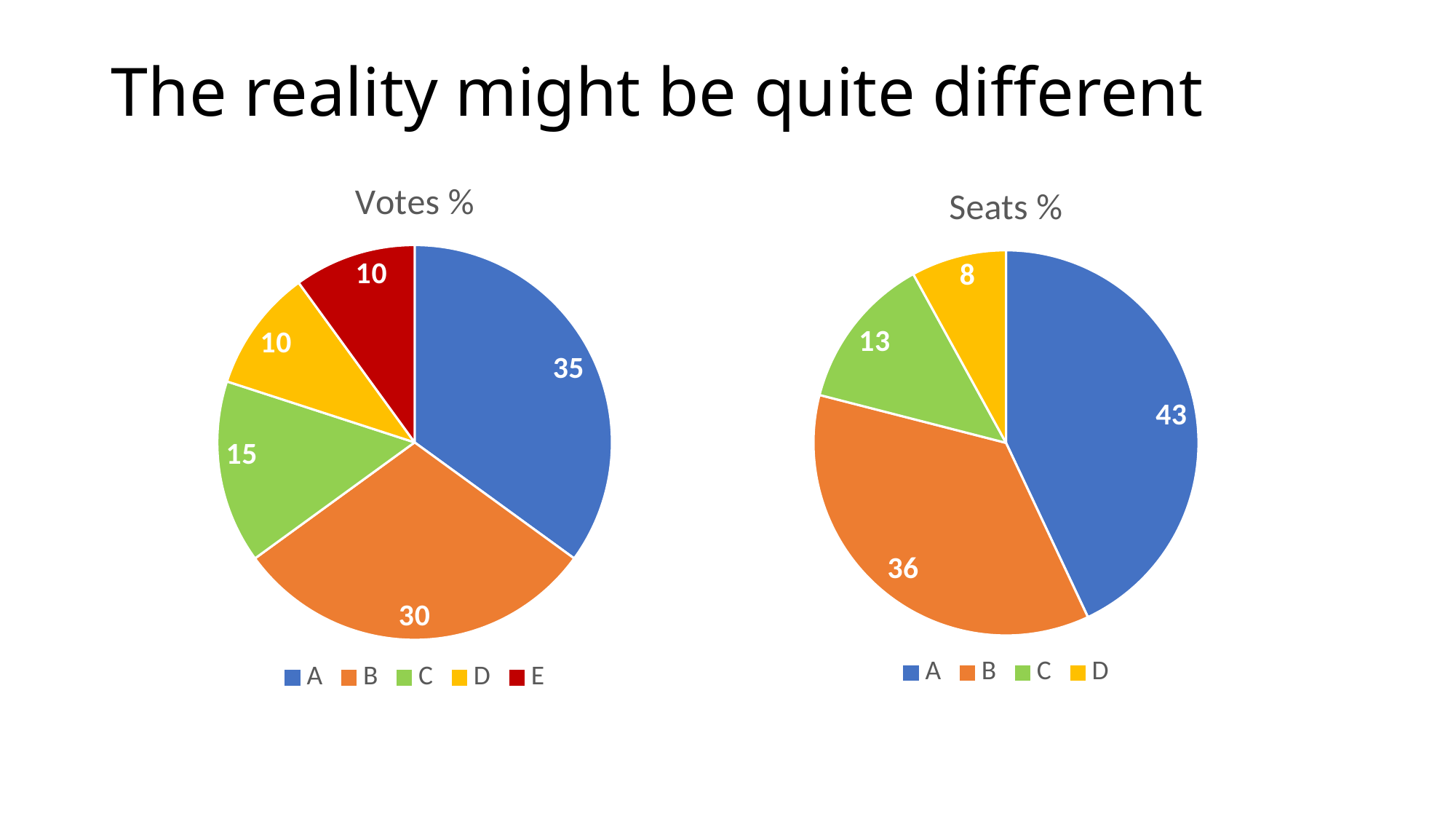
In the Votes % chart, what is the difference between the values for B and C? 15 In the Seats % chart, what is the value for D? 8 What is the difference between the value for A in the Seats % chart and the value for A in the Votes % chart? 8 In the Seats % chart, which is larger, the value for C or the value for D? C In the Seats % chart, which category has the smallest slice? D What kind of chart is the Seats % chart? Pie chart In the Seats % chart, what is the value for B? 36 How many categories does the legend of the Seats % chart list? 4 In the Votes % chart, which category has the largest slice? A How many slices does the Votes % chart have? 5 Which category appears in the Votes % chart legend but not in the Seats % chart legend? E In the Votes % chart, what is the value for A? 35